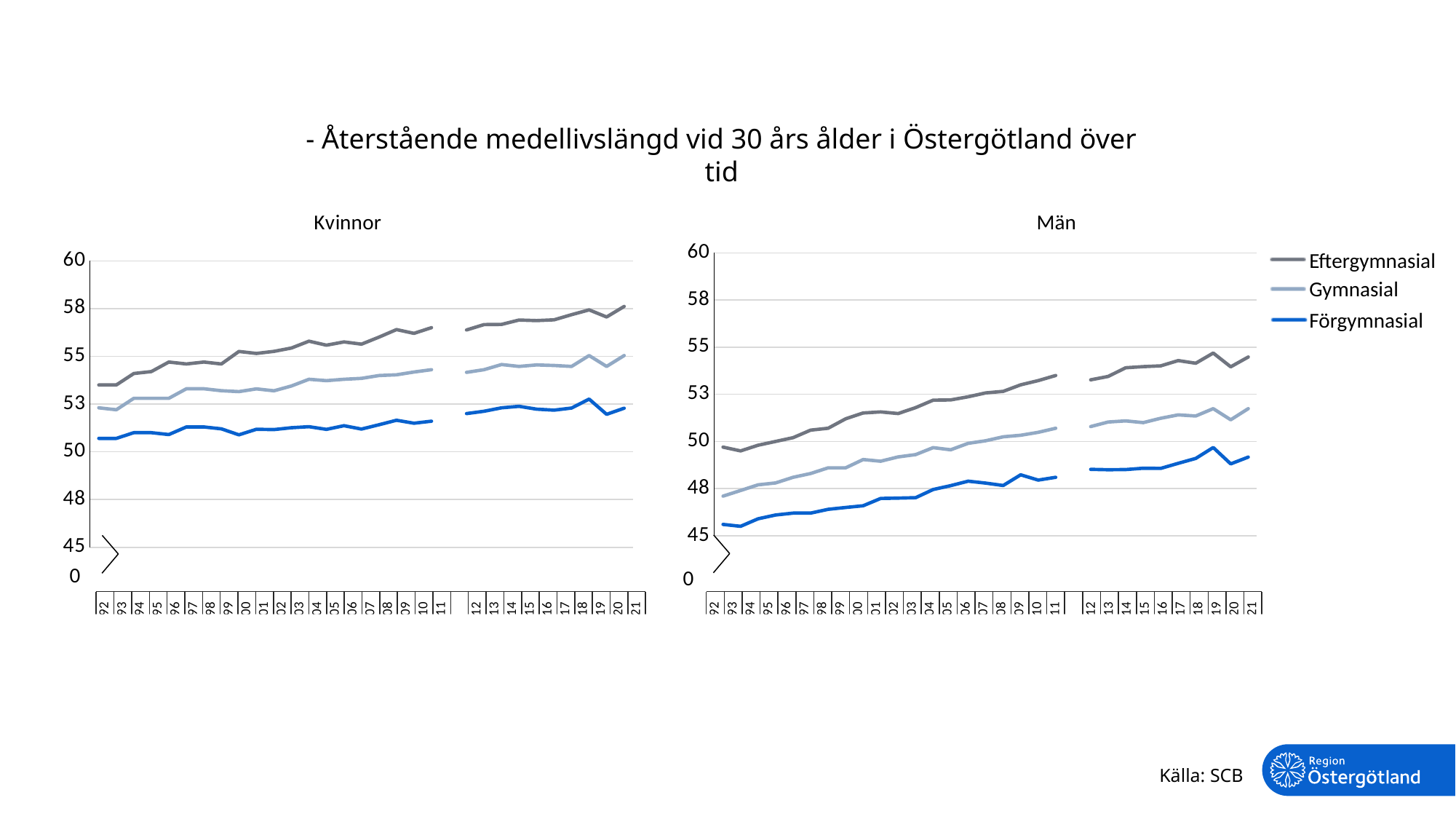
In the Kvinnor chart, which series has the highest values throughout the period? Eftergymnasial In the Män chart, which series has the lowest values throughout the period? Förgymnasial In the Män chart, is the value for Gymnasial in 21 greater or less than 53? less How many series does the legend list? 3 What kind of chart is the Kvinnor chart? line chart In the Män chart, is the value for Förgymnasial in 92 greater or less than 48? less How many years are shown on the x axis of the Män chart? 30 In the Män chart, does the Eftergymnasial line generally rise or fall from 92 to 21? rise In the Kvinnor chart, is the value for Eftergymnasial in 92 greater or less than 53? greater What source is cited at the bottom of the slide? SCB Which is larger in 21: Eftergymnasial in the Kvinnor chart or Eftergymnasial in the Män chart? Kvinnor In the Kvinnor chart, does the Gymnasial line generally rise or fall from 92 to 21? rise